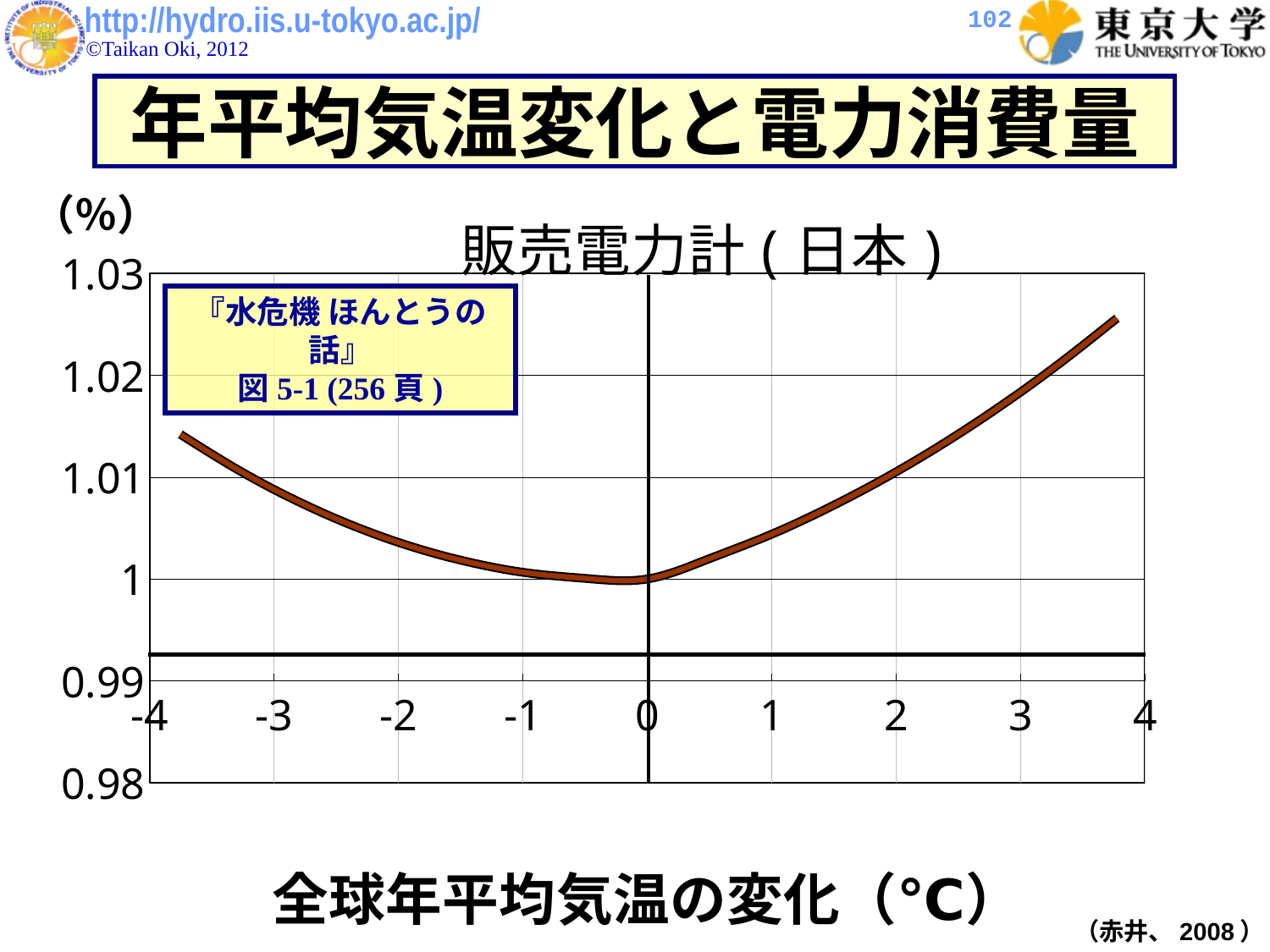
Is the value of the curve at x = -2 greater or less than 1.01? less Does the curve rise or fall as the x axis goes from 0 to 4? rise Is the value of the curve at x = 2 greater or less than 1? greater Is the value at the right end of the curve greater or less than 1.02? greater What is the title of the chart? 販売電力計(日本) Which is larger, the value of the curve at x = 3 or at x = -3? x = 3 How many tick labels are shown on the x axis? 9 What is the label of the x axis of the chart? 全球年平均気温の変化(°C) What kind of chart is shown on the slide? line chart Does the curve rise or fall as the x axis goes from -4 to 0? fall